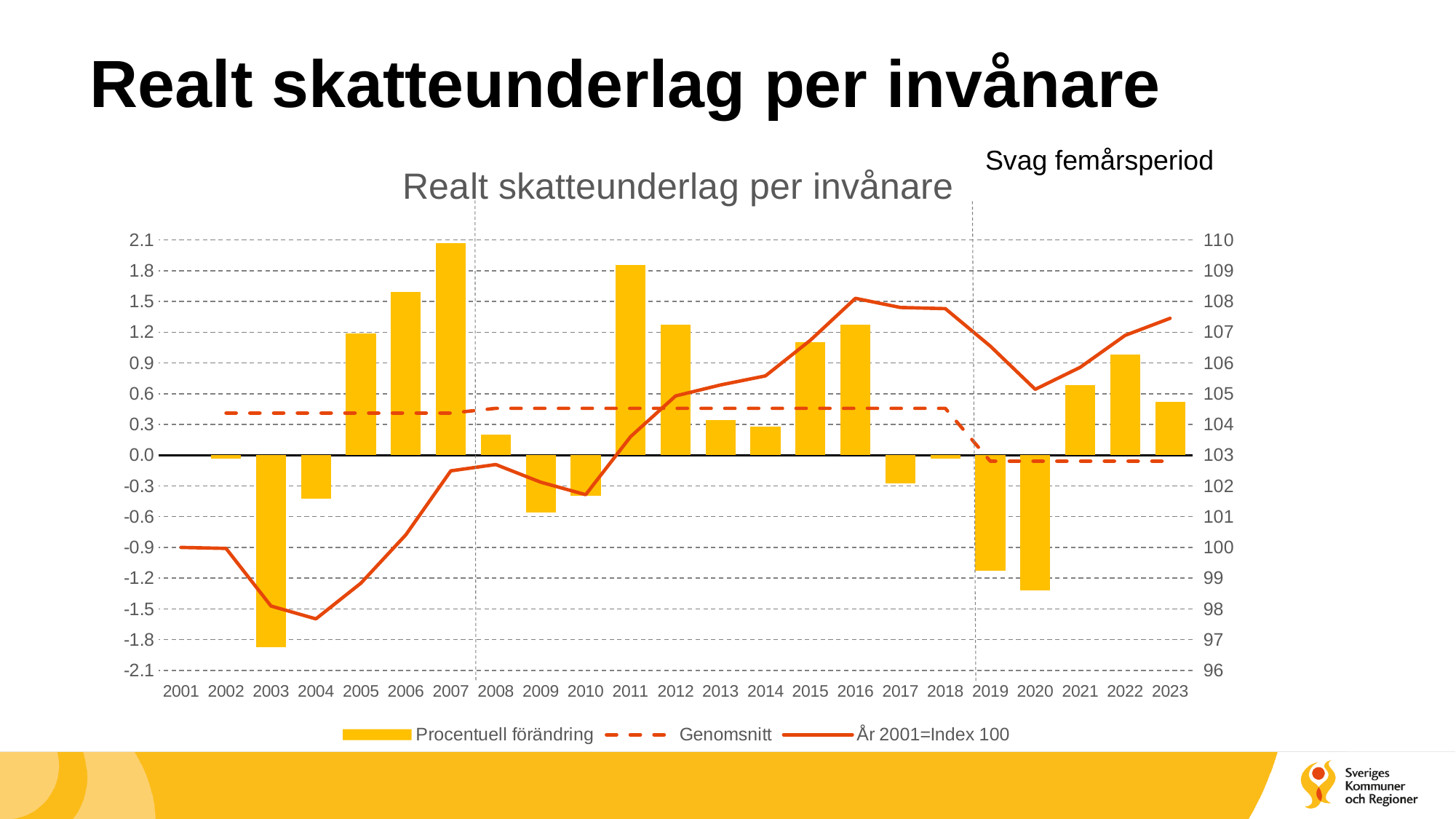
Which year has the highest bar for Procentuell förändring? 2007 Which year has the larger Procentuell förändring bar, 2011 or 2012? 2011 Is the Procentuell förändring bar for 2003 greater or less than -1.5? less What kind of chart is shown on the slide? Combined bar and line chart Is the Procentuell förändring bar for 2020 greater or less than -1.2? less How many years are shown on the x axis? 23 Is the År 2001=Index 100 line value for 2016 greater or less than 107? greater What is the title of the chart? Realt skatteunderlag per invånare Which year has the lowest bar for Procentuell förändring? 2003 Does the År 2001=Index 100 line rise or fall overall from 2001 to 2023? rise How many series does the legend list? 3